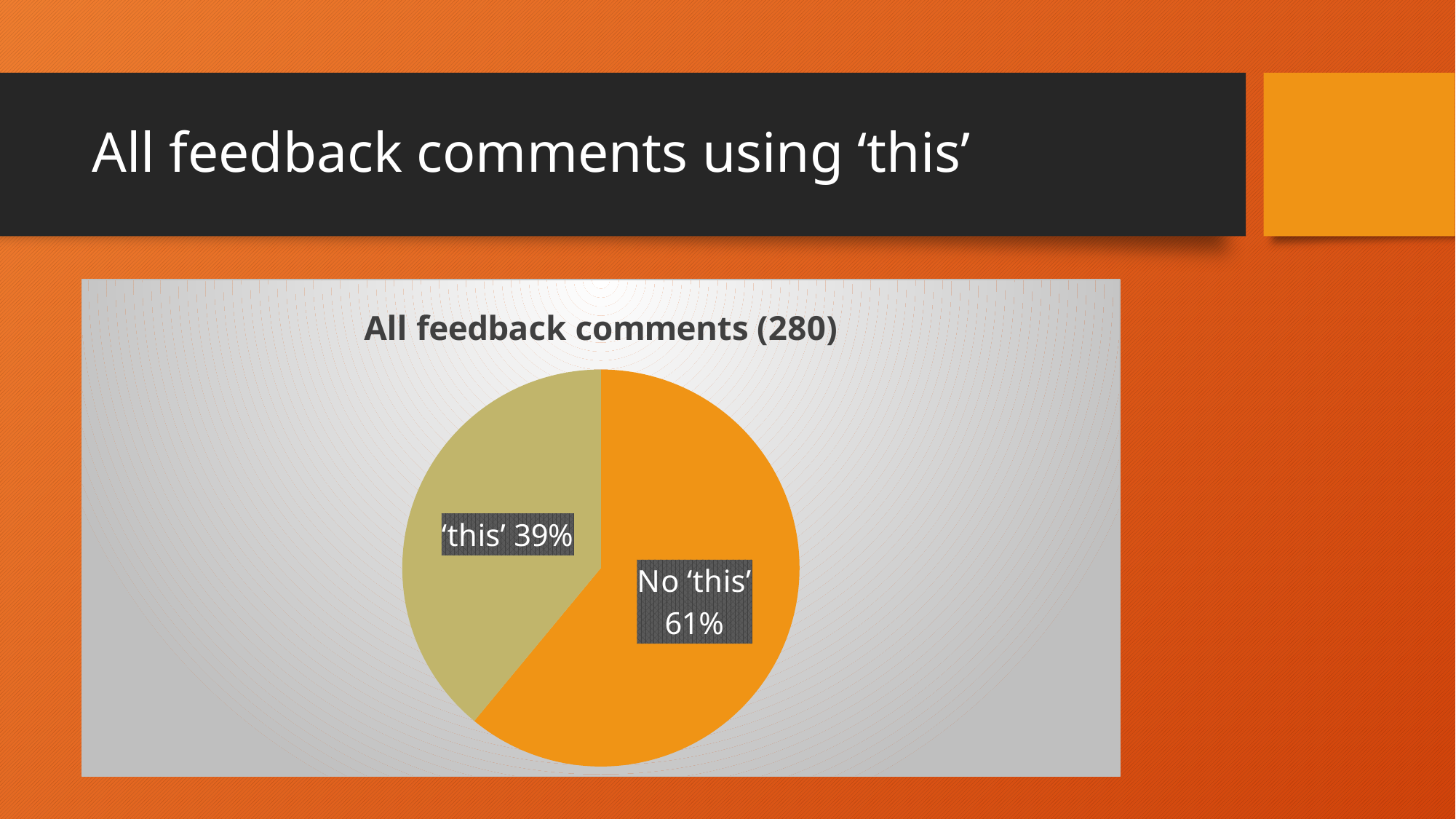
What share of the pie is labelled 'this'? 39% Which slice of the pie is the largest? No 'this' Which slice of the pie is the smallest? 'this' What colour is the No 'this' slice? orange How many slices does the pie chart have? 2 What share of the pie is labelled No 'this'? 61% What kind of chart is shown on the slide? pie chart How many feedback comments in total does the chart title state? 280 Which is larger, the 'this' slice or the No 'this' slice? No 'this' What is the difference in percentage points between the No 'this' slice and the 'this' slice? 22 What is the title of the chart? All feedback comments (280)